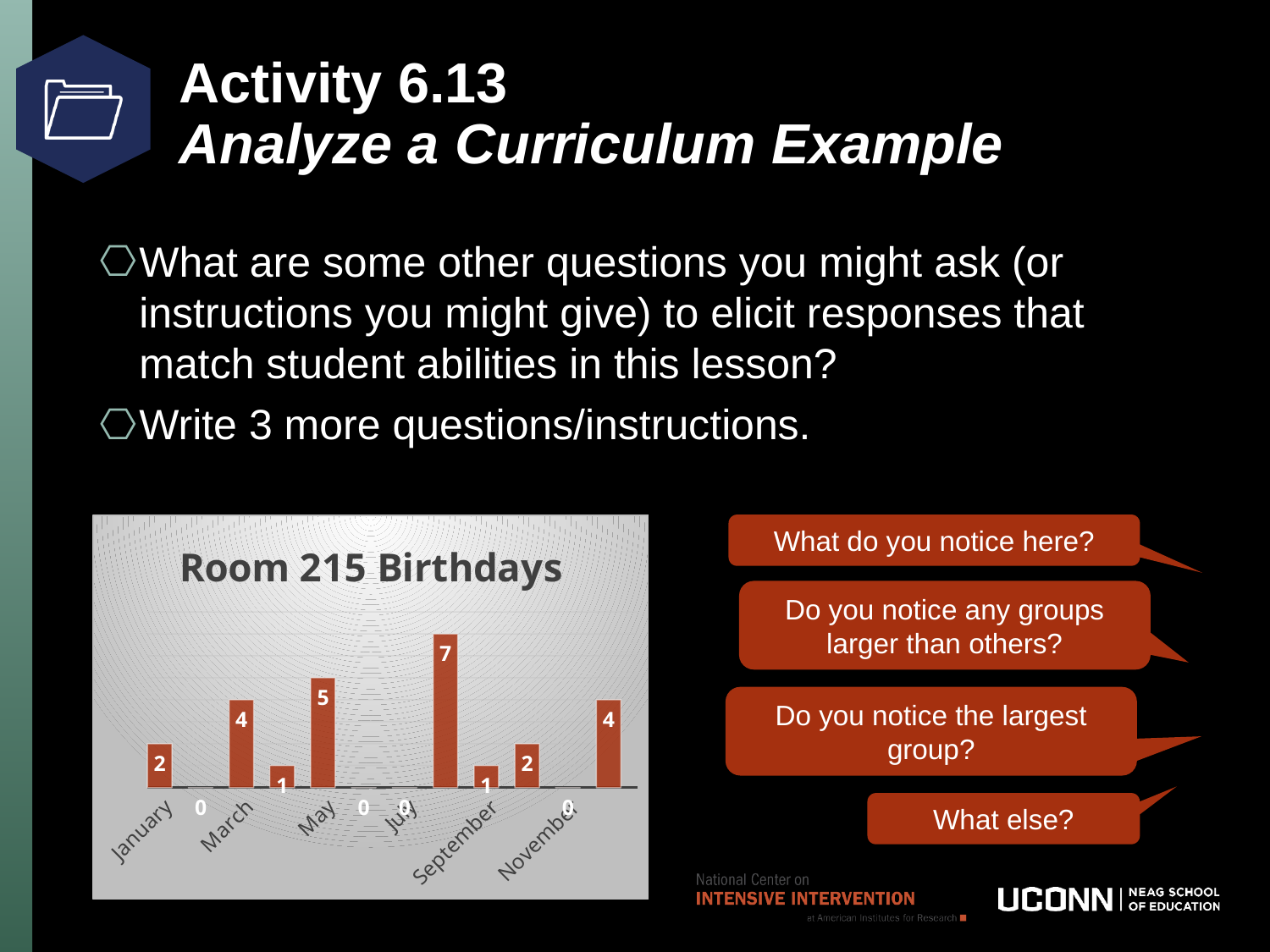
What is the difference between the values for May and January? 3 What is the value for May? 5 What is the value for November? 0 How many bars (months) are plotted in the chart? 12 How many birthdays are shown for January? 2 What is the value for September? 1 What is the value for July? 0 What is the value for March? 4 What kind of chart is shown on the slide? bar chart What is the highest value shown on any bar in the chart? 7 What is the title of the chart? Room 215 Birthdays Which has more birthdays, March or May? May